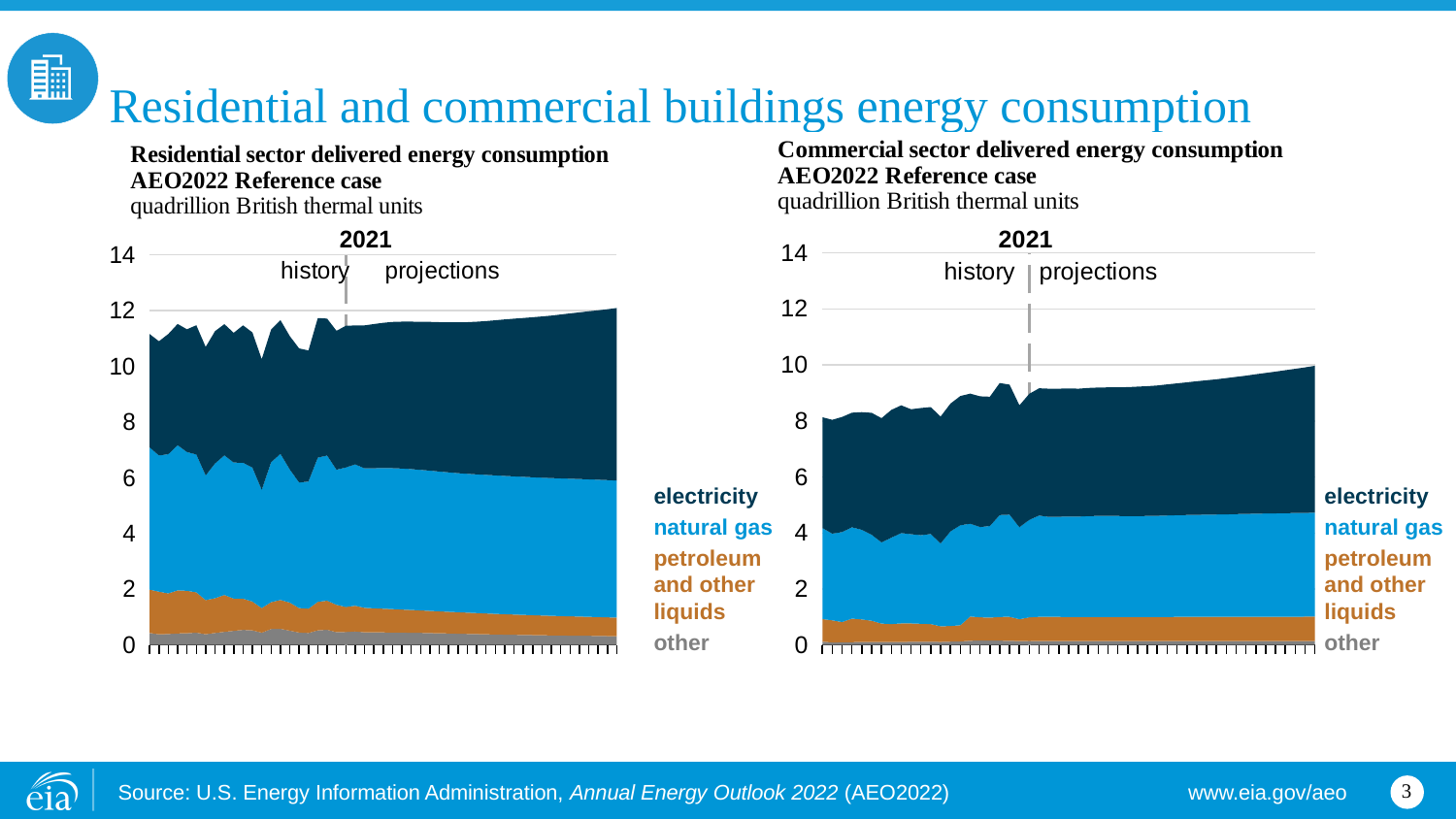
In the Residential sector chart, what unit is shown on the y axis? quadrillion British thermal units In the Residential sector chart, is the natural gas component at the end of the projection period greater or less than 2? greater Which chart shows the higher total delivered energy consumption at the end of the projection period, Residential or Commercial? Residential In the Commercial sector chart, is the total delivered energy consumption at the start of the history period greater or less than 10? less In the Residential sector chart, which series is the largest component of delivered energy consumption at the end of the projection period? electricity In the Commercial sector chart, which series is the largest component of delivered energy consumption at the end of the projection period? electricity In the Commercial sector chart, does total delivered energy consumption rise or fall over the projection period? rise In the Commercial sector chart, which year separates history from projections? 2021 In the Commercial sector chart, is the total delivered energy consumption at the end of the projection period greater or less than 8? greater What kind of chart is the Residential sector delivered energy consumption chart? stacked area chart How many series does the legend of the Commercial sector delivered energy consumption chart list? 4